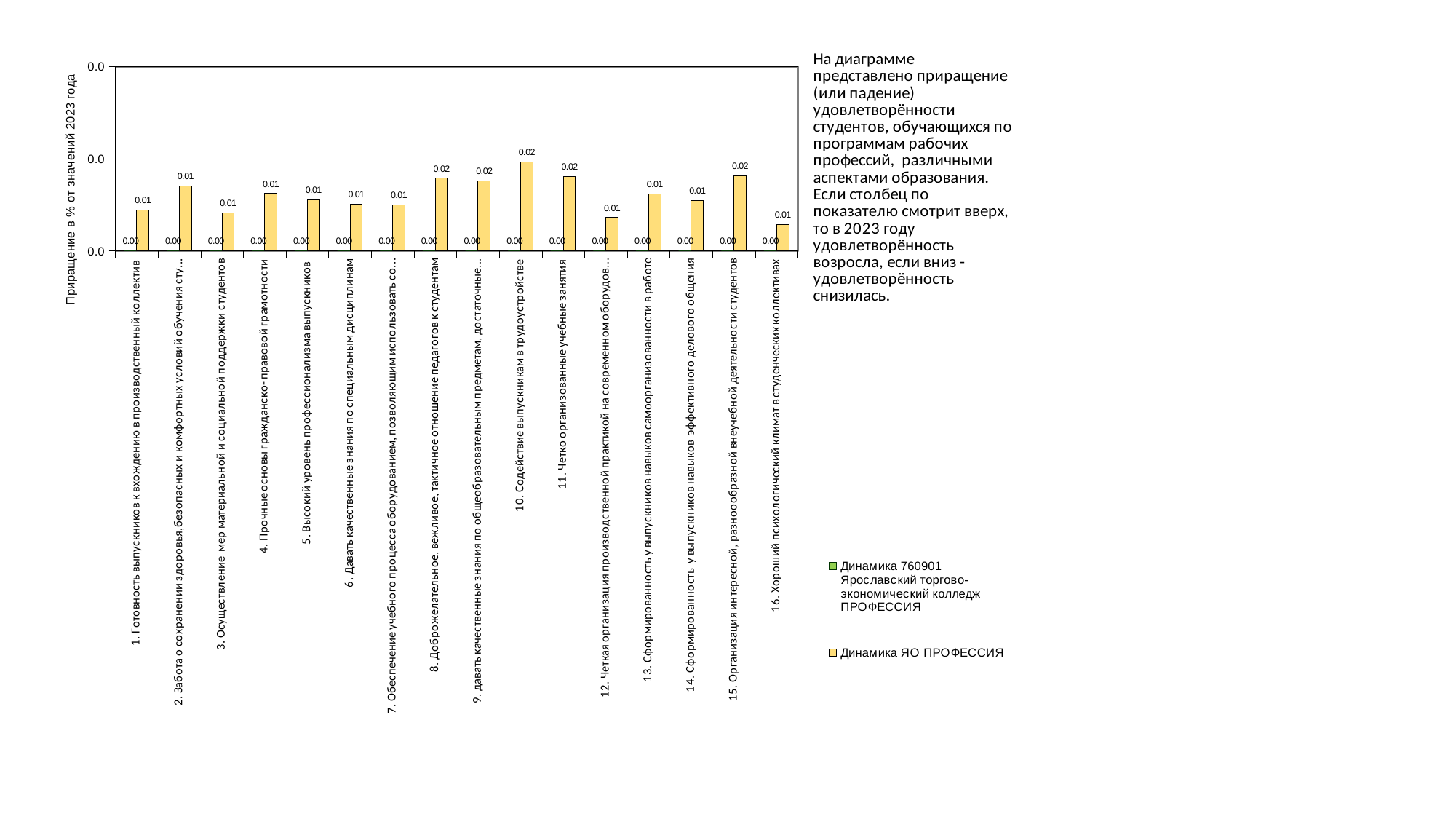
What is the difference between the 'Динамика ЯО ПРОФЕССИЯ' values for category '8. Доброжелательное, вежливое, тактичное отношение педагогов к студентам' and category '12. Четкая организация производственной практикой на современном оборудов…'? 0.01 What is the value of the 'Динамика ЯО ПРОФЕССИЯ' series for category '1. Готовность выпускников к вхождению в производственный коллектив'? 0.01 What is the value of the 'Динамика 760901 Ярославский торгово-экономический колледж ПРОФЕССИЯ' series for category '5. Высокий уровень профессионализма выпускников'? 0.00 What is the value of the 'Динамика ЯО ПРОФЕССИЯ' series for category '11. Четко организованные учебные занятия'? 0.02 How many categories are plotted along the x axis? 16 How many series does the legend list? 2 What is the title of the vertical axis? Приращение в % от значений 2023 года What kind of chart is shown on the slide? bar chart Which category has the shortest bar for the 'Динамика ЯО ПРОФЕССИЯ' series? 16. Хороший психологический климат в студенческих коллективах What is the value of the 'Динамика ЯО ПРОФЕССИЯ' series for category '10. Содействие выпускникам в трудоустройстве'? 0.02 For the 'Динамика ЯО ПРОФЕССИЯ' series, which is larger: the value for category 10 or the value for category 16? category 10 Which category has the tallest bar for the 'Динамика ЯО ПРОФЕССИЯ' series? 10. Содействие выпускникам в трудоустройстве